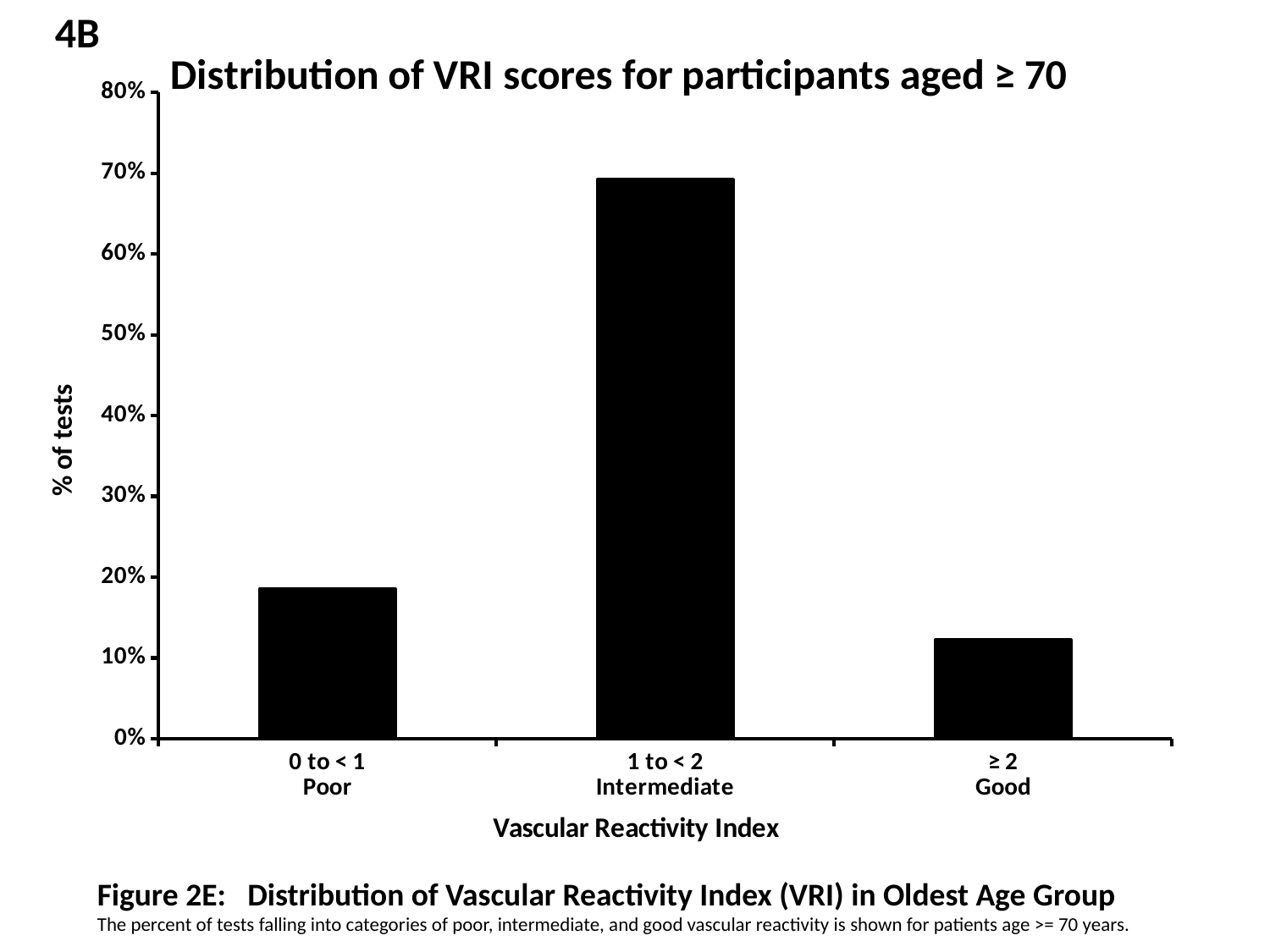
How many categories are shown on the x axis of the chart? 3 What type of chart is shown on the slide? bar chart Is the value for the ≥ 2 Good category greater or less than 10%? greater What is the label of the y axis? % of tests Which category has a larger percentage of tests, 1 to < 2 Intermediate or 0 to < 1 Poor? 1 to < 2 Intermediate Which Vascular Reactivity Index category has the lowest percentage of tests? ≥ 2 Good Is the value for the 0 to < 1 Poor category greater or less than 20%? less What is the title of the chart? Distribution of VRI scores for participants aged ≥ 70 Which Vascular Reactivity Index category has the highest percentage of tests? 1 to < 2 Intermediate Which category has a larger percentage of tests, 0 to < 1 Poor or ≥ 2 Good? 0 to < 1 Poor Is the value for the 1 to < 2 Intermediate category greater or less than 60%? greater